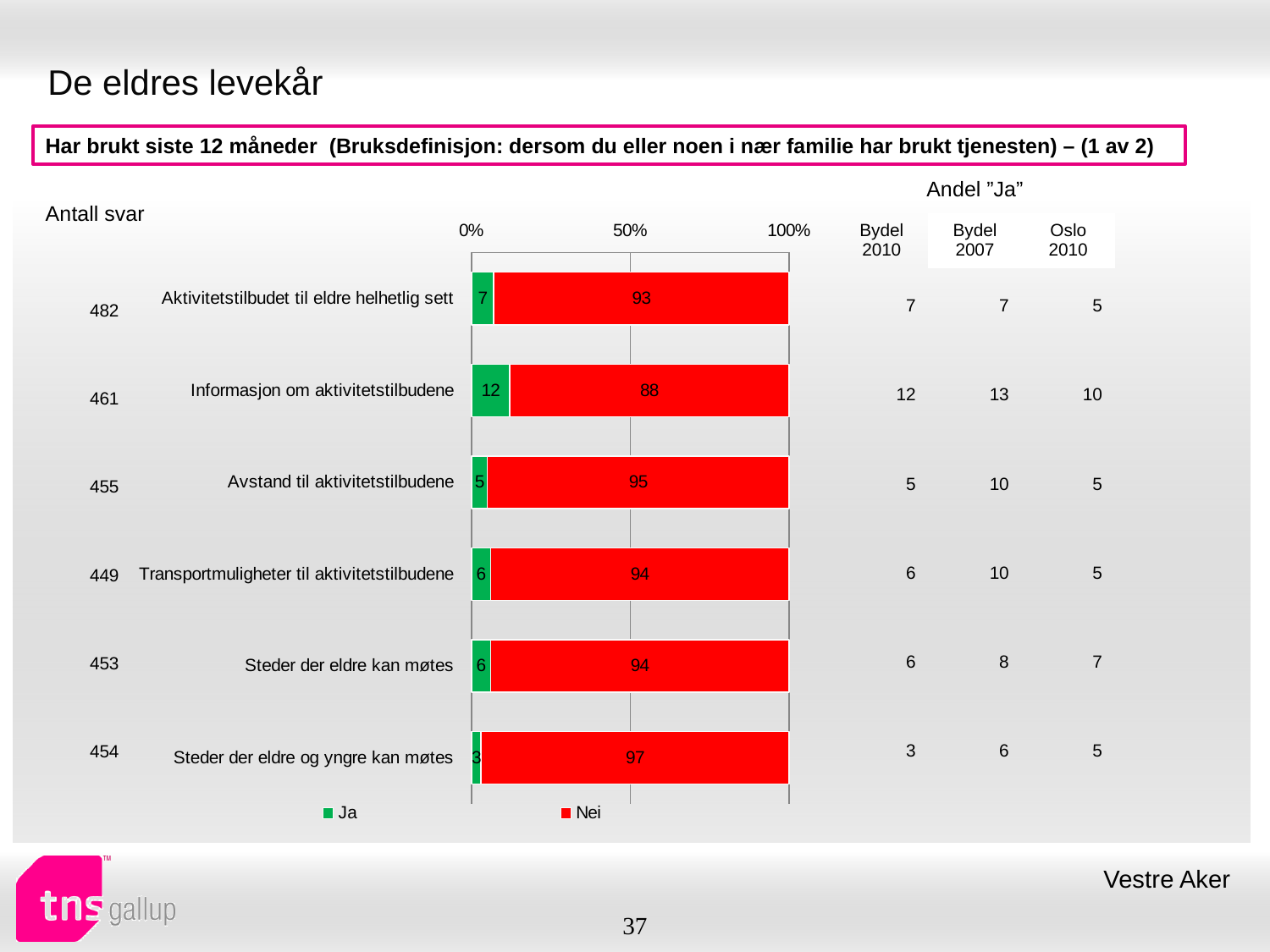
What is the "Nei" value for "Steder der eldre og yngre kan møtes"? 97 Which colour represents the "Nei" series in the chart? red Which category has the lowest "Ja" value? Steder der eldre og yngre kan møtes What is the "Nei" value for "Informasjon om aktivitetstilbudene"? 88 How many series does the chart legend list? 2 What is the difference between the "Nei" values for "Steder der eldre og yngre kan møtes" and "Informasjon om aktivitetstilbudene"? 9 What kind of chart is shown on the slide? stacked bar chart Which is larger, the "Ja" value for "Avstand til aktivitetstilbudene" or for "Transportmuligheter til aktivitetstilbudene"? Transportmuligheter til aktivitetstilbudene What is the total of the stacked bar for "Steder der eldre kan møtes"? 100 Which category has the highest "Ja" value? Informasjon om aktivitetstilbudene What is the "Ja" value for "Aktivitetstilbudet til eldre helhetlig sett"? 7 How many categories are plotted in the chart? 6